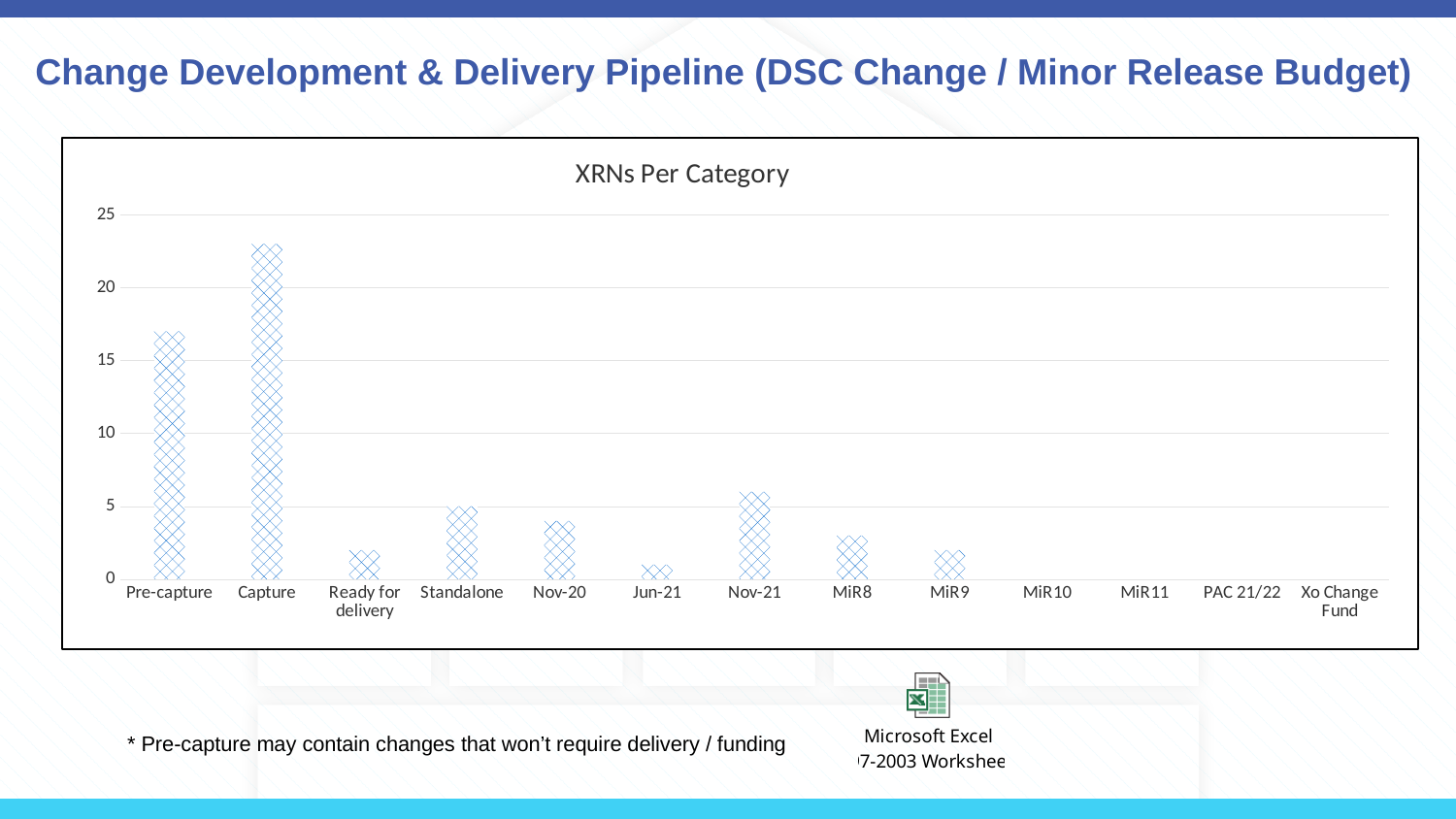
Is the value for Capture greater or less than 20? greater Is the value for Ready for delivery greater or less than 5? less Which category has the highest value in the chart? Capture Which is larger, the value for Pre-capture or the value for Capture? Capture What is the highest value shown on the y axis of the chart? 25 Is the value for Pre-capture greater or less than 20? less How many categories are shown on the x axis of the chart? 13 What kind of chart is shown on the slide? bar chart What is the title of the chart? XRNs Per Category Which is larger, the value for Nov-20 or the value for Nov-21? Nov-21